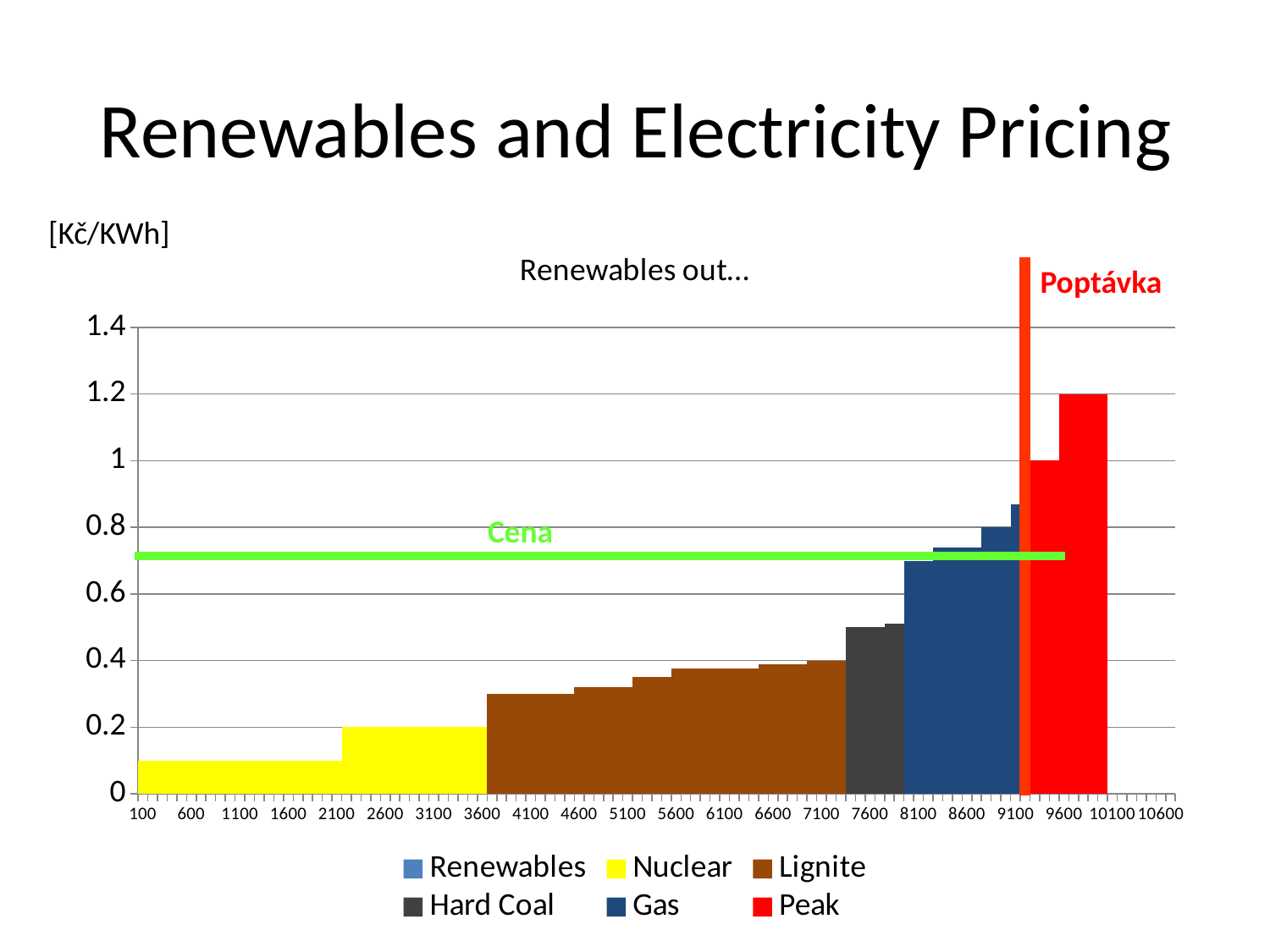
What kind of chart is shown on the slide? bar chart Which series has the tallest bars in the chart? Peak Is the value of the first Nuclear bars greater or less than 0.2? less How many series does the chart legend list? 6 What unit is shown for the vertical axis of the chart? Kč/KWh What is the title of the chart? Renewables out… Are the Gas bars higher or lower than the Lignite bars? higher Which series has the lowest bars in the chart? Nuclear What is the value of the tallest Peak bar? 1.2 Is the value of the Hard Coal bars greater or less than 0.4? greater Is the green 'Cena' line above or below 0.6 on the vertical axis? above Do the bar values rise or fall moving from left to right along the x axis? rise